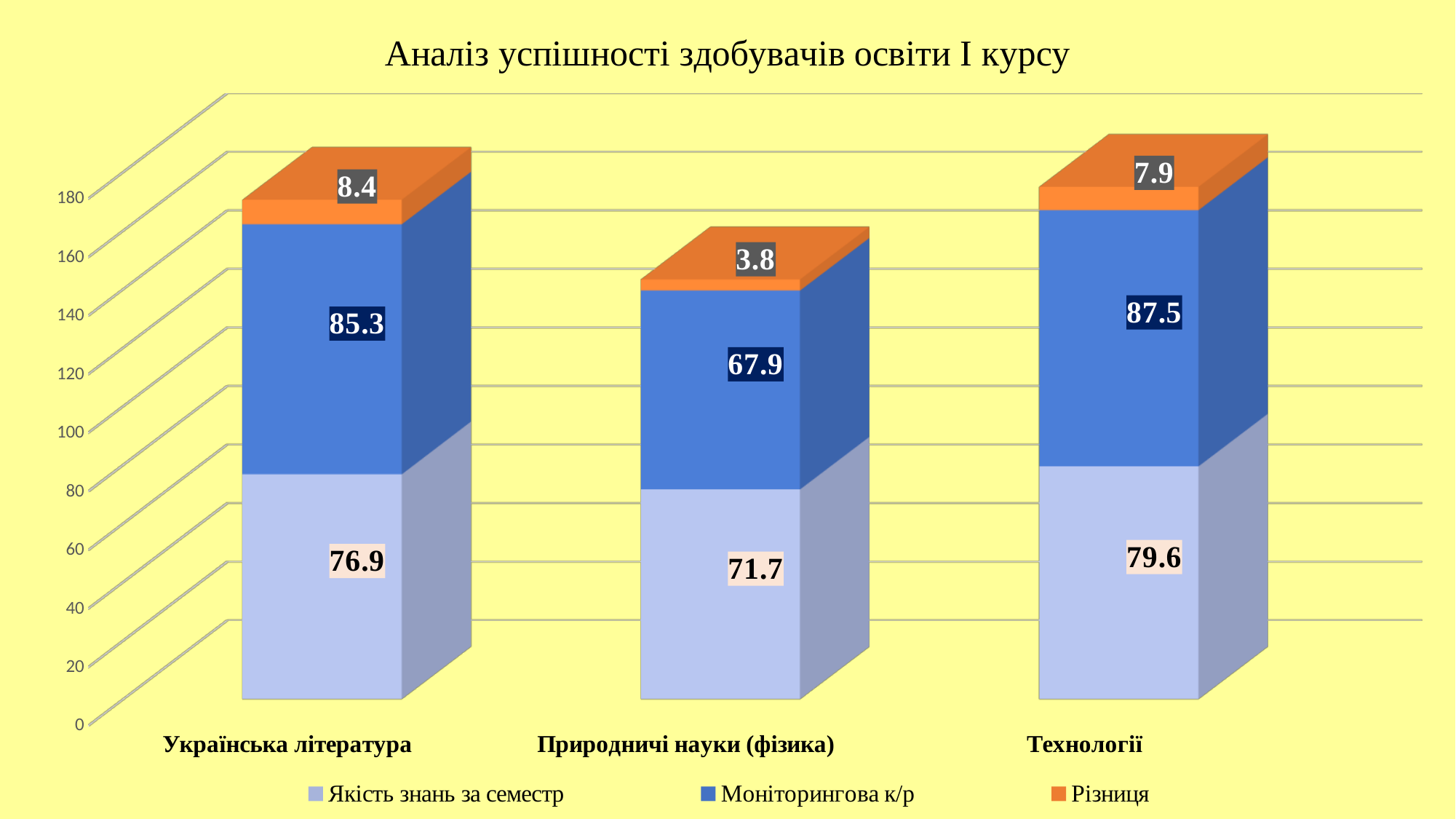
How many series does the legend list? 3 What is the title of the chart? Аналіз успішності здобувачів освіти І курсу How many categories are shown on the x axis? 3 What type of chart is shown on the slide? Stacked bar chart What is the value of "Різниця" for Технології? 7.9 What is the value of "Якість знань за семестр" for Українська література? 76.9 Which category has the highest value for "Моніторингова к/р"? Технології What is the total of the stacked bar for Природничі науки (фізика)? 143.4 What is the value of "Моніторингова к/р" for Природничі науки (фізика)? 67.9 Which category has the lowest value for "Якість знань за семестр"? Природничі науки (фізика) Which is larger: the "Різниця" value for Українська література or for Технології? Українська література What is the difference between the "Моніторингова к/р" values for Технології and Українська література? 2.2